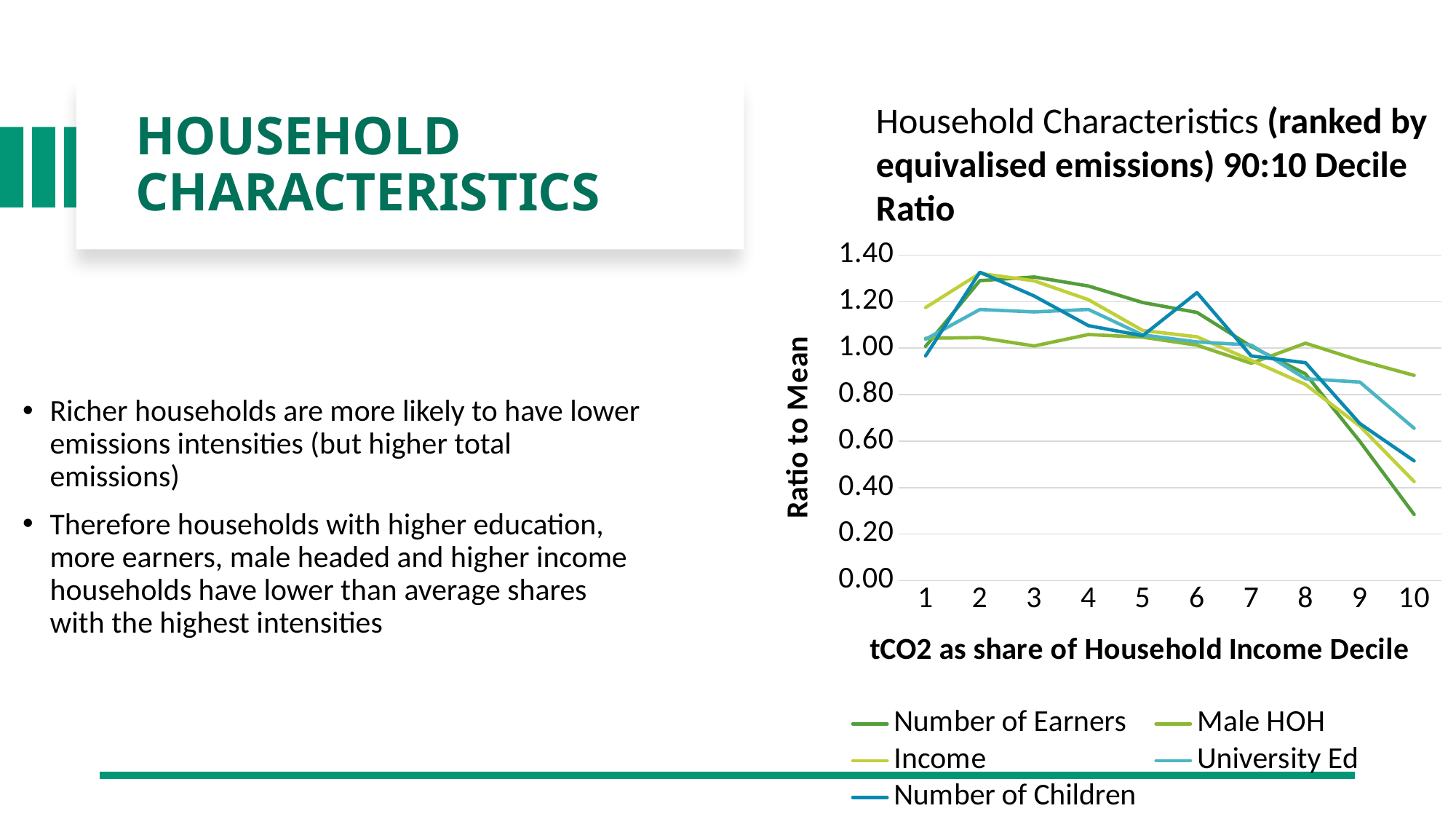
How many series does the chart legend list? 5 How many income deciles are plotted along the x axis? 10 What kind of chart is shown on the slide? Line chart Do the series values generally rise or fall from decile 5 to decile 10? Fall At decile 10, which is larger: the value for University Ed or the value for Number of Children? University Ed Is the value for University Ed at decile 10 greater or less than 0.80? less What is the highest tick value shown on the y axis? 1.40 What is the title of the chart's y axis? Ratio to Mean Is the value for Number of Children at decile 10 greater or less than 0.60? less What is the title of the chart's x axis? tCO2 as share of Household Income Decile Is the value for Number of Children at decile 2 greater or less than 1.20? greater